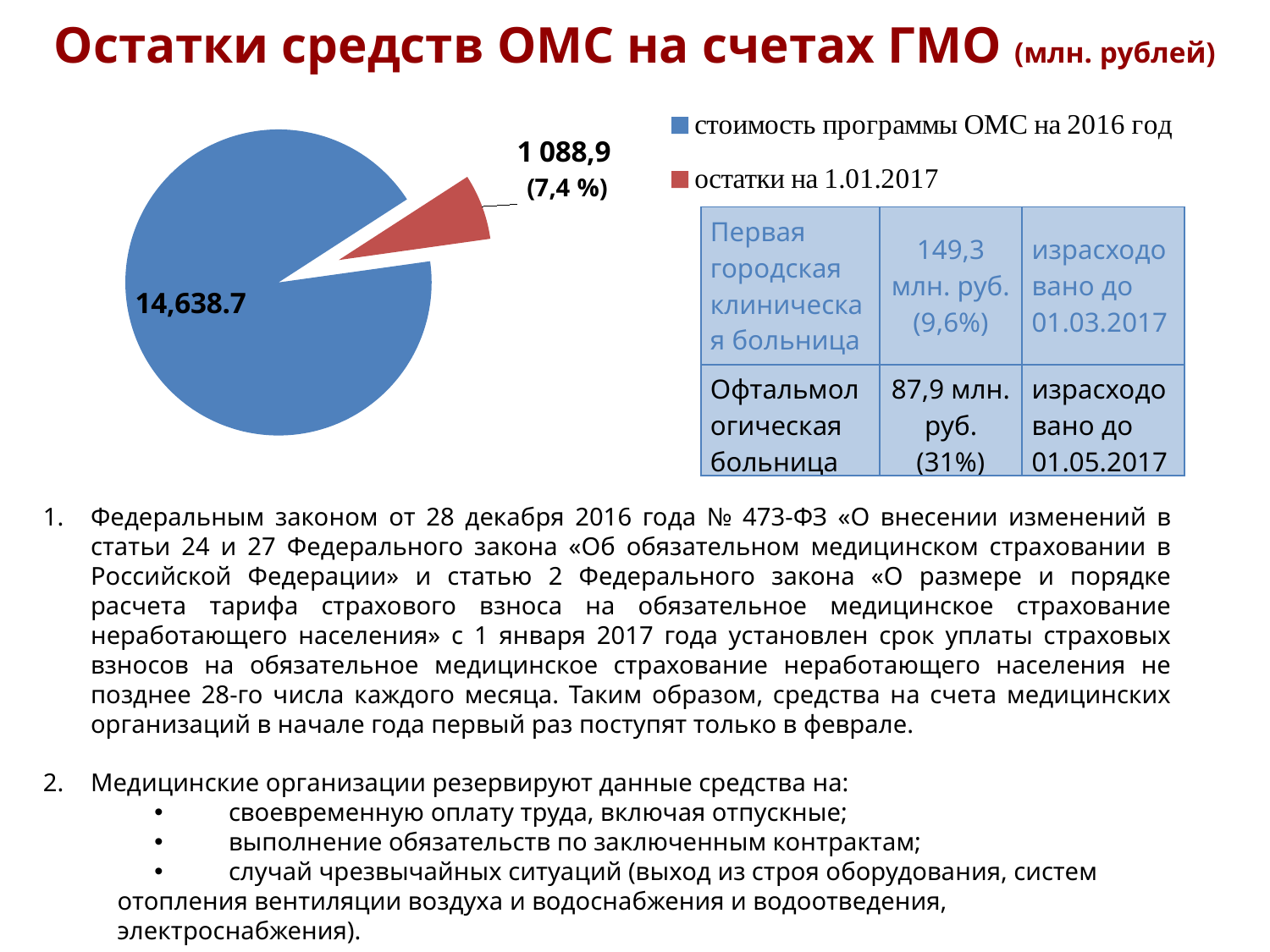
What value is shown for "остатки на 1.01.2017" in the pie chart? 1 088,9 What share of the pie does the "остатки на 1.01.2017" slice represent? 7,4 % Which slice of the pie chart is the largest? стоимость программы ОМС на 2016 год What value is shown for "стоимость программы ОМС на 2016 год" in the pie chart? 14,638.7 Which slice of the pie chart is the smallest? остатки на 1.01.2017 How many slices does the pie chart have? 2 What is the title of the chart on the slide? Остатки средств ОМС на счетах ГМО (млн. рублей) Which is larger in the pie chart: "стоимость программы ОМС на 2016 год" or "остатки на 1.01.2017"? стоимость программы ОМС на 2016 год How many entries does the legend of the pie chart list? 2 What kind of chart is shown on the slide? pie chart What colour is the "остатки на 1.01.2017" slice in the pie chart? red